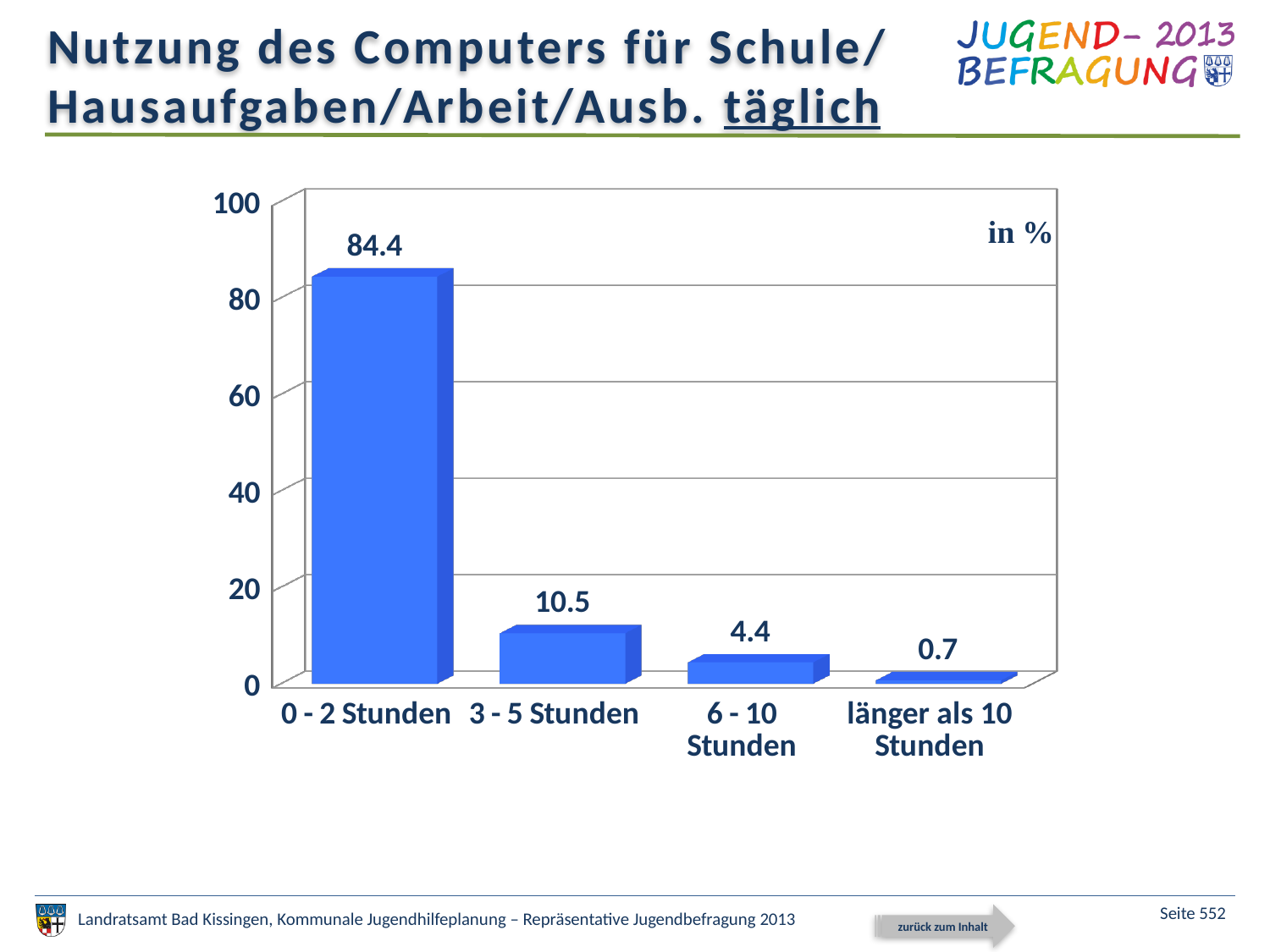
Which category has the lowest value? länger als 10 Stunden What is the value for "6 - 10 Stunden"? 4.4 What is the difference between the values for "0 - 2 Stunden" and "3 - 5 Stunden"? 73.9 What kind of chart is shown on the slide? bar chart Which is larger, the value for "3 - 5 Stunden" or the value for "6 - 10 Stunden"? 3 - 5 Stunden What is the value for "0 - 2 Stunden"? 84.4 What is the value for "länger als 10 Stunden"? 0.7 Do the values rise or fall from left to right along the x axis? fall What is the value for "3 - 5 Stunden"? 10.5 Is the value for "0 - 2 Stunden" greater or less than 80? greater Which category has the highest value? 0 - 2 Stunden How many categories are shown on the x axis? 4